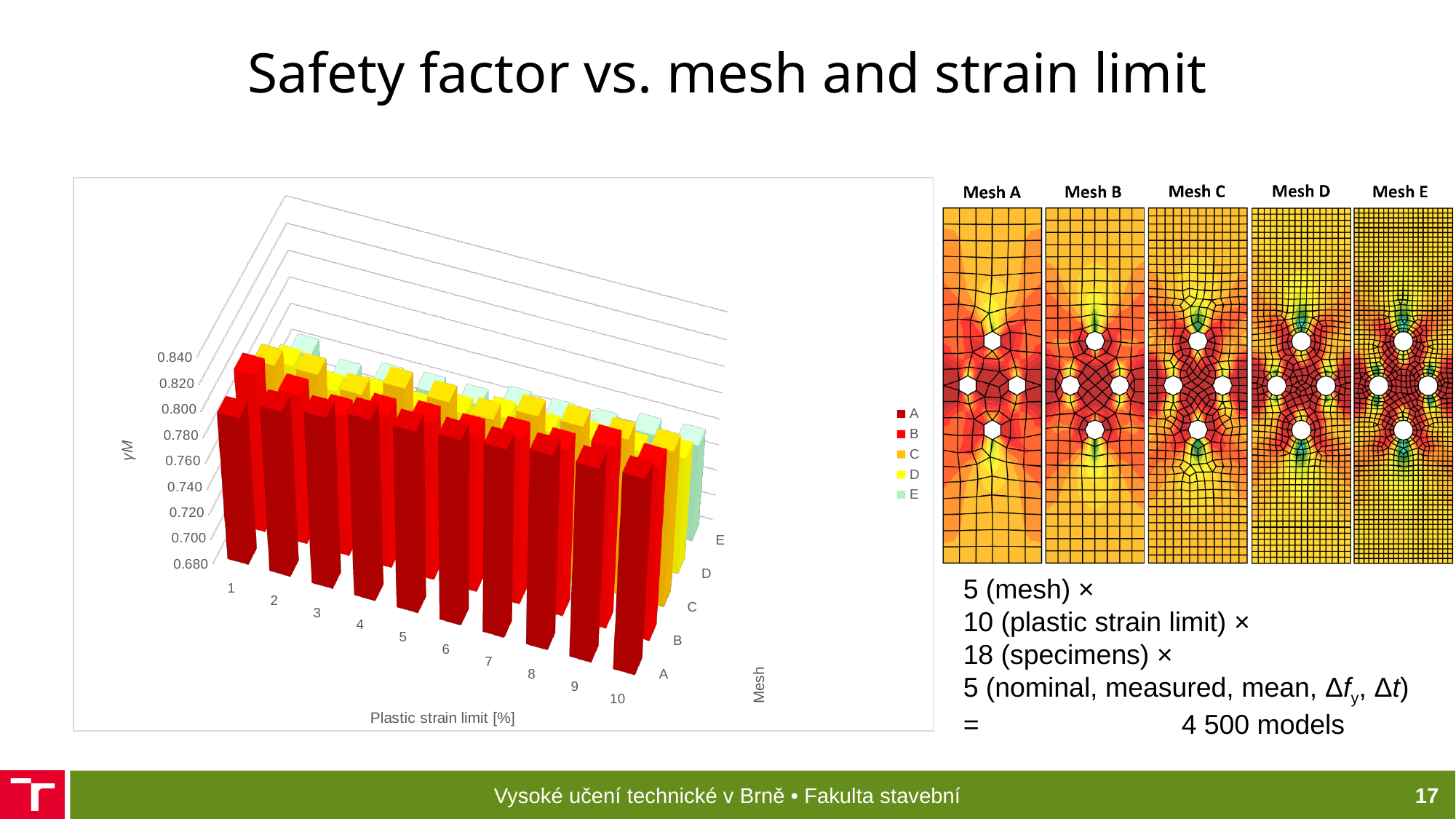
What are the series names listed in the chart's legend? A, B, C, D, E What is the lowest tick value shown on the vertical axis of the chart? 0.680 How many plastic strain limit categories are shown along the x axis of the chart? 10 What kind of chart is shown on the left of the slide? bar chart How many series does the chart's legend list? 5 What is the label of the horizontal axis of the chart? Plastic strain limit [%] What is the highest tick value shown on the vertical axis of the chart? 0.840